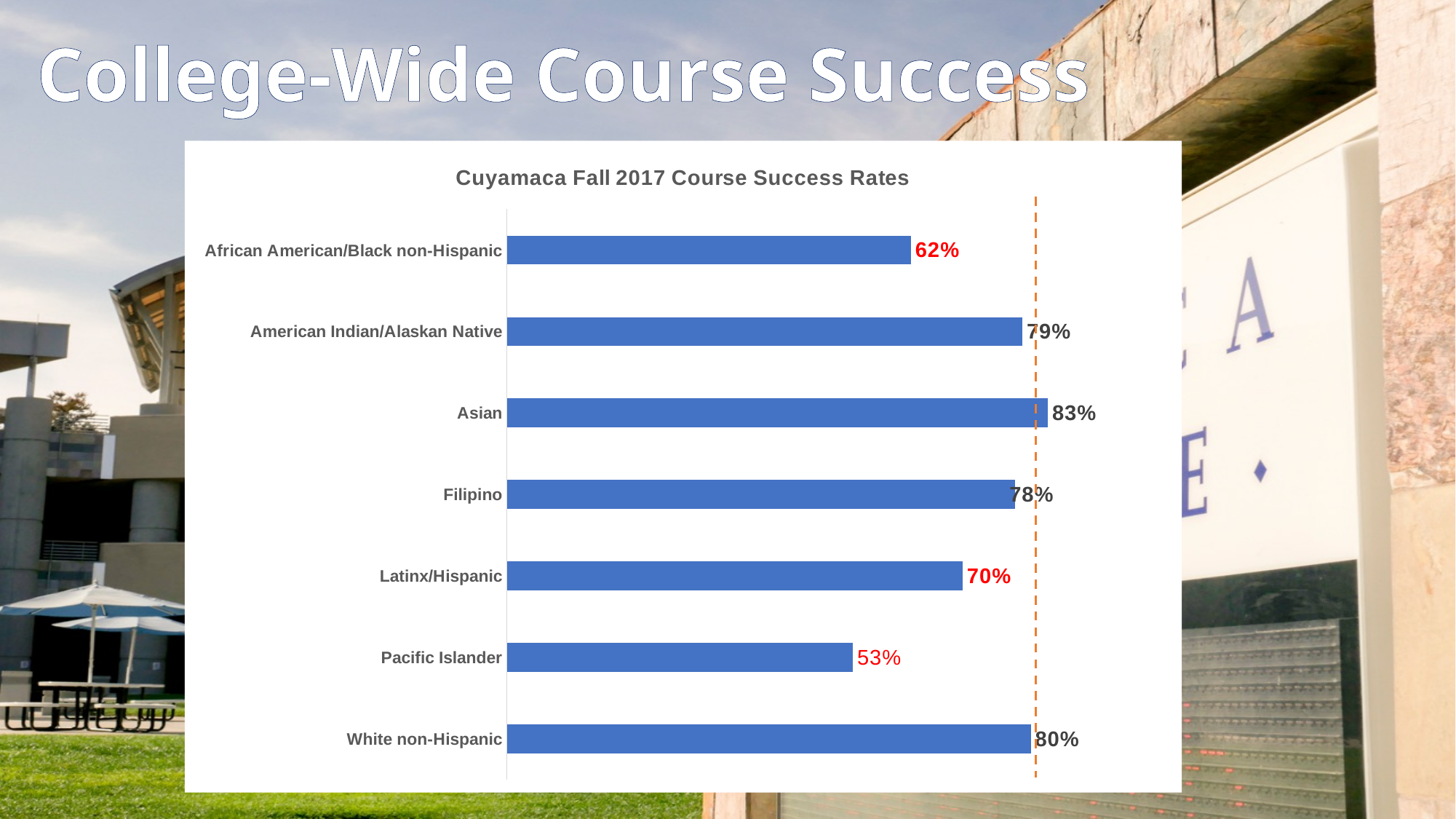
How many groups are shown in the chart? 7 Which group has a higher success rate, American Indian/Alaskan Native or Filipino? American Indian/Alaskan Native What is the difference between the success rates of White non-Hispanic and Pacific Islander students? 27% What is the course success rate for Pacific Islander students? 53% Which group has the lowest course success rate? Pacific Islander What is the course success rate for Latinx/Hispanic students? 70% What is the difference between the success rates of Asian and African American/Black non-Hispanic students? 21% What is the course success rate for African American/Black non-Hispanic students? 62% What is the course success rate for Asian students? 83% Which group has the highest course success rate? Asian What is the title of the chart? Cuyamaca Fall 2017 Course Success Rates What kind of chart is shown on the slide? Bar chart